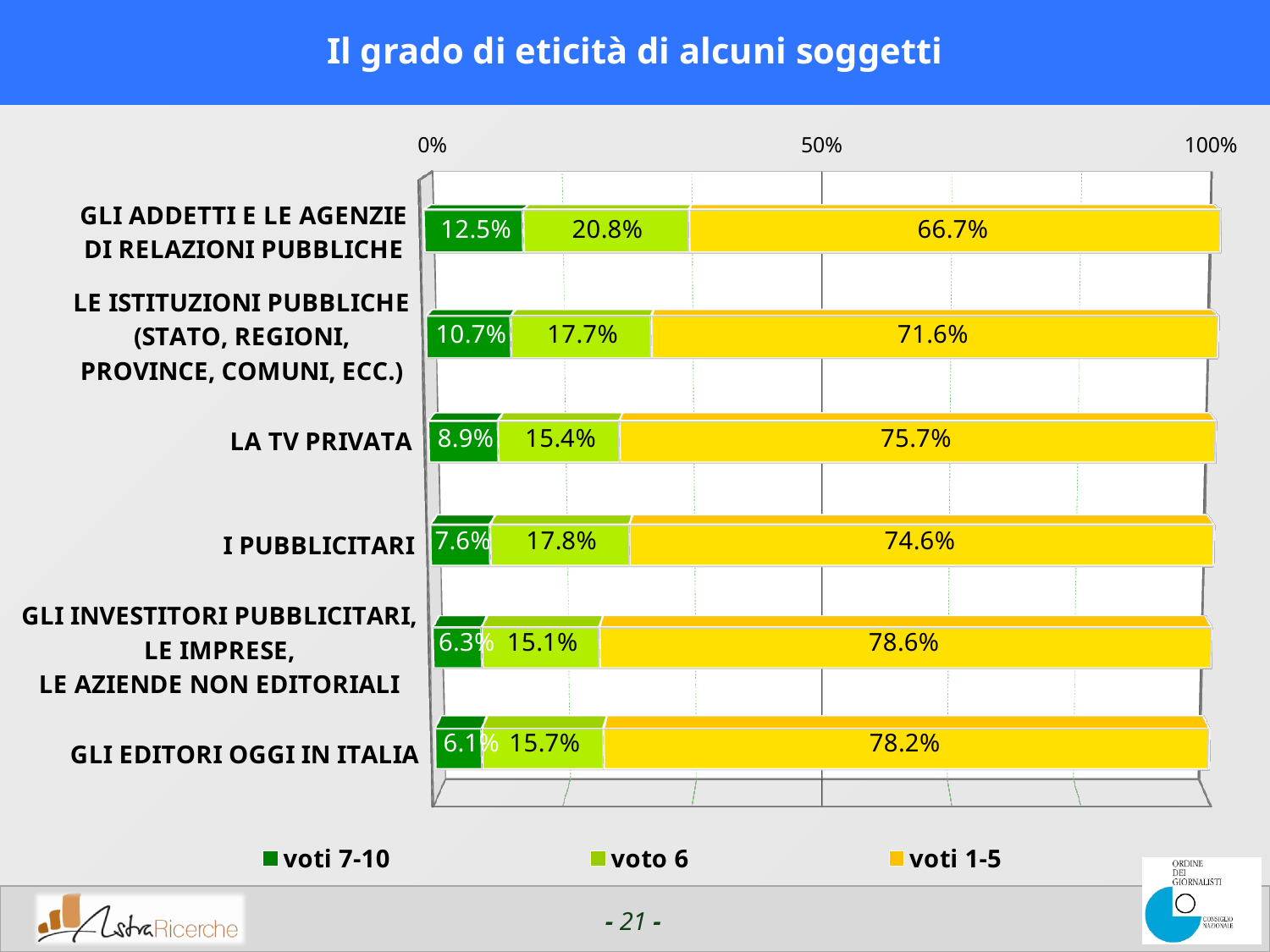
Which category has the highest 'voti 7-10' value? GLI ADDETTI E LE AGENZIE DI RELAZIONI PUBBLICHE What kind of chart is shown on the slide? Stacked bar chart What is the 'voti 7-10' value for LA TV PRIVATA? 8.9% How many categories are shown in the chart? 6 What is the 'voto 6' value for GLI EDITORI OGGI IN ITALIA? 15.7% What is the title of the chart? Il grado di eticità di alcuni soggetti Which category has the lowest 'voti 1-5' value? GLI ADDETTI E LE AGENZIE DI RELAZIONI PUBBLICHE What is the 'voti 1-5' value for LE ISTITUZIONI PUBBLICHE (STATO, REGIONI, PROVINCE, COMUNI, ECC.)? 71.6% Is the 'voti 1-5' value for GLI INVESTITORI PUBBLICITARI, LE IMPRESE, LE AZIENDE NON EDITORIALI greater or less than 50%? greater How many series does the legend list? 3 Which has a larger 'voto 6' value: I PUBBLICITARI or LA TV PRIVATA? I PUBBLICITARI What is the difference between the 'voti 1-5' value for GLI EDITORI OGGI IN ITALIA and for GLI ADDETTI E LE AGENZIE DI RELAZIONI PUBBLICHE? 11.5 percentage points